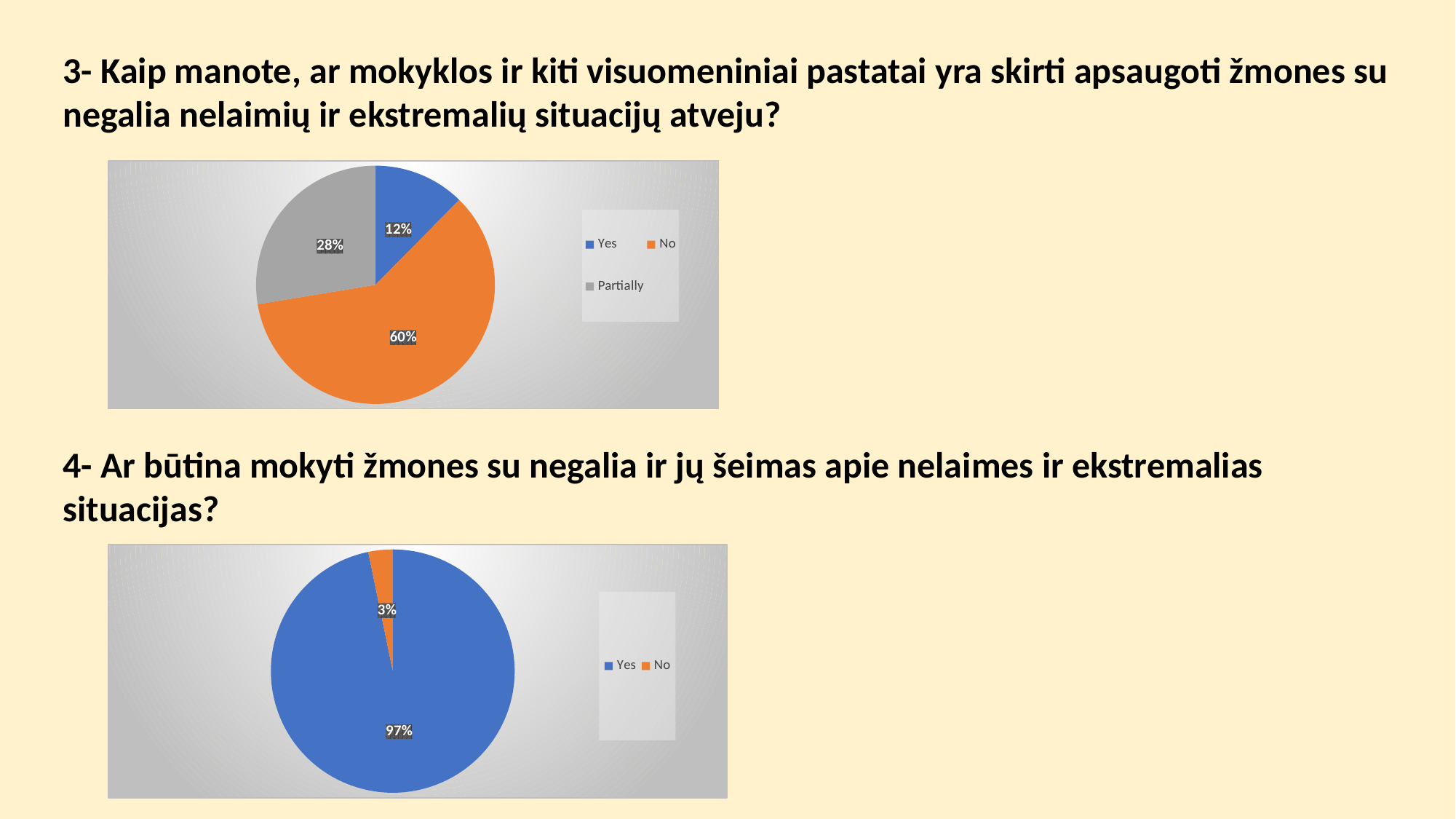
In the top pie chart (question 3), how many entries does the legend list? 3 In the top pie chart (question 3), which response has the largest share? No In the bottom pie chart (question 4), how many slices does the pie have? 2 In the top pie chart (question 3), what share of responses is 'Partially'? 28% What type of chart is used for question 4 at the bottom of the slide? Pie chart In the bottom pie chart (question 4), which is larger, 'Yes' or 'No'? Yes In the bottom pie chart (question 4), what share of responses is 'No'? 3% In the top pie chart (question 3), what share of responses is 'Yes'? 12% In the top pie chart (question 3), which response has the smallest share? Yes In the top pie chart (question 3), what is the difference in percentage points between 'No' and 'Partially'? 32 In the top pie chart (question 3), what share of responses is 'No'? 60% In the bottom pie chart (question 4), what share of responses is 'Yes'? 97%